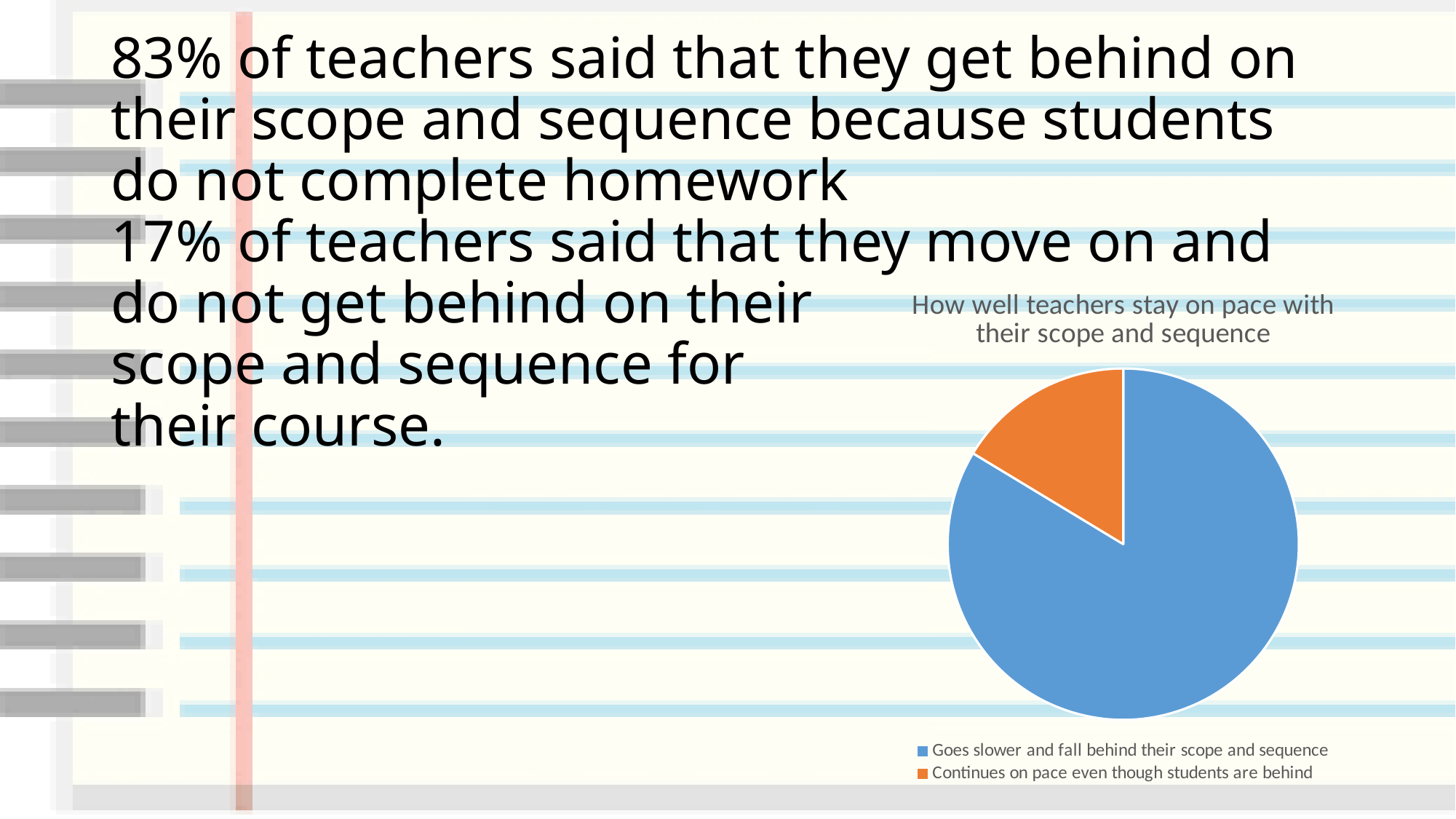
How many slices does the pie chart have? 2 Which slice of the pie chart is the smallest? Continues on pace even though students are behind What kind of chart is shown on the slide? pie chart According to the slide, what share of teachers does the 'Goes slower and fall behind their scope and sequence' slice represent? 83% What is the title of the pie chart? How well teachers stay on pace with their scope and sequence Which is larger in the pie chart: 'Goes slower and fall behind their scope and sequence' or 'Continues on pace even though students are behind'? Goes slower and fall behind their scope and sequence How many entries does the legend of the pie chart list? 2 Which slice of the pie chart is the largest? Goes slower and fall behind their scope and sequence Is the share of the 'Goes slower and fall behind their scope and sequence' slice greater or less than 50%? greater According to the slide, what share of teachers does the 'Continues on pace even though students are behind' slice represent? 17% Is the share of the 'Continues on pace even though students are behind' slice greater or less than 25%? less What colour is the 'Continues on pace even though students are behind' slice in the pie chart? orange